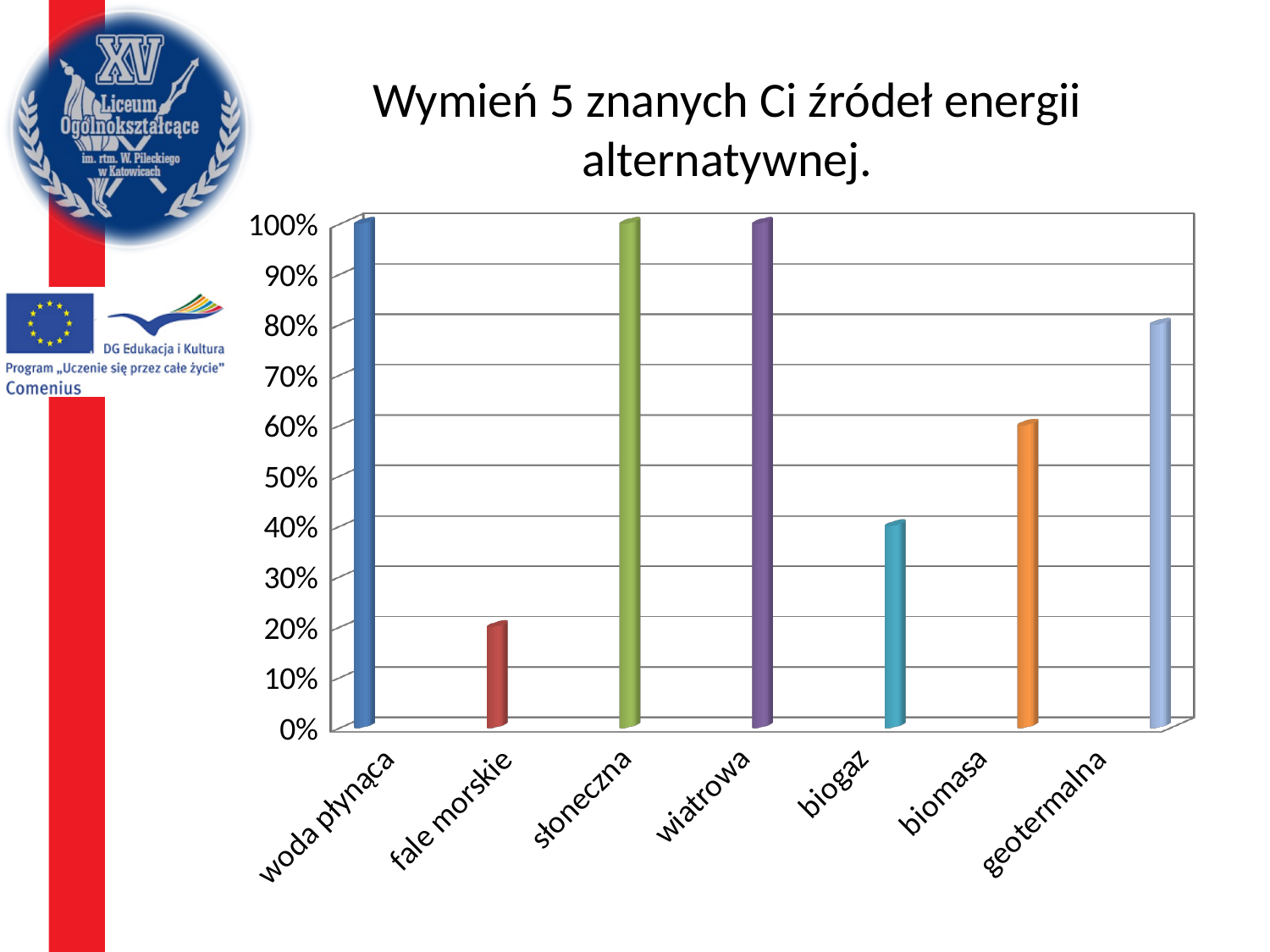
What kind of chart is shown on the slide? bar chart What is the value for fale morskie? 20% What is the value for biomasa? 60% What is the value for biogaz? 40% Which is larger, the value for biomasa or the value for biogaz? biomasa What is the title of the chart? Wymień 5 znanych Ci źródeł energii alternatywnej. Is the value for biogaz greater or less than 50%? less What is the value for geotermalna? 80% What is the difference between the values for geotermalna and biomasa? 20% Which category has the lowest value in the chart? fale morskie Is the value for wiatrowa greater or less than 90%? greater How many categories (energy sources) are shown on the x axis of the chart? 7